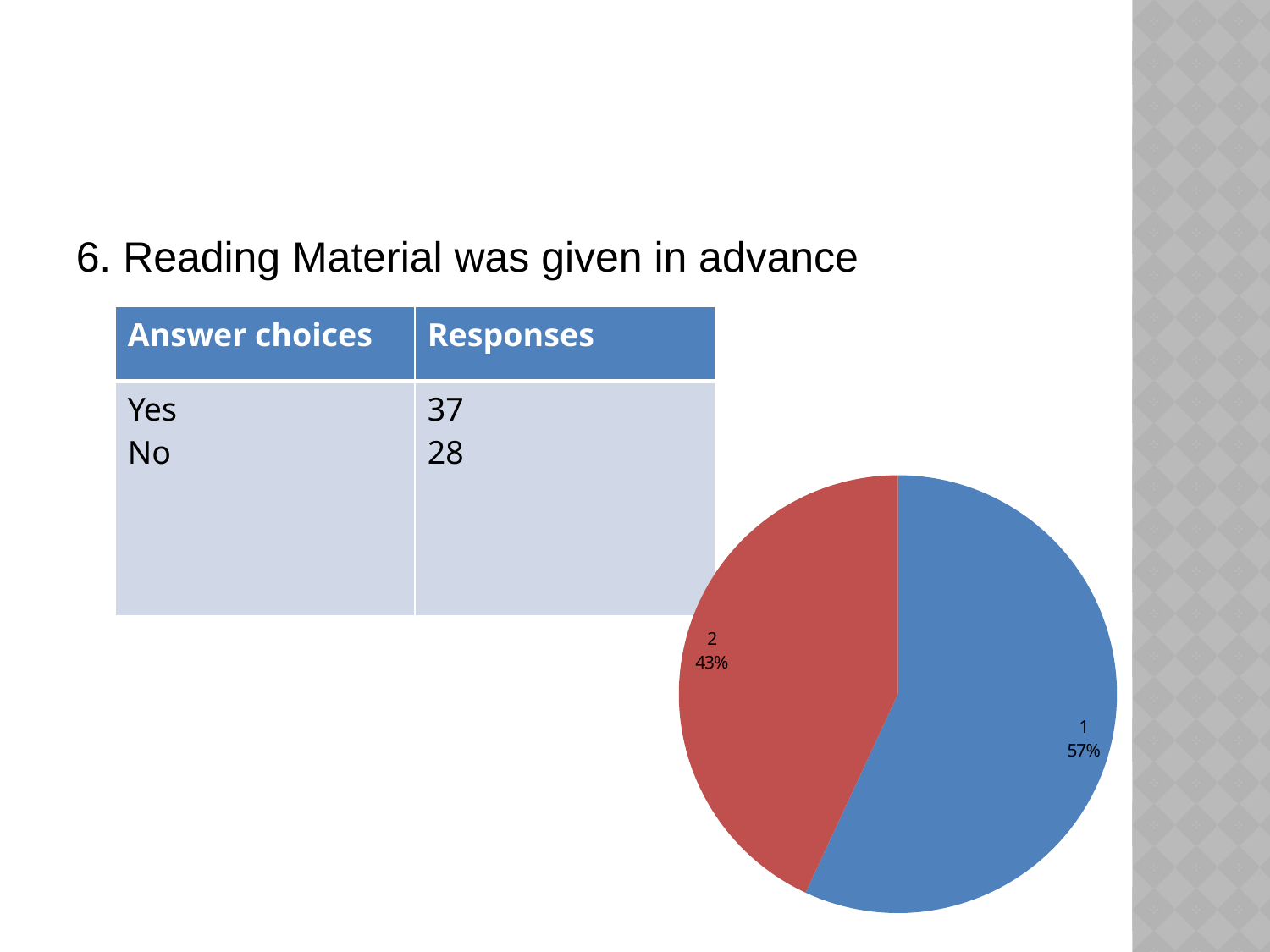
Which slice of the pie chart is the smallest? 2 Is the share for slice 2 in the pie chart greater or less than 50%? less What is the difference in percentage points between slice 1 and slice 2 in the pie chart? 14 percentage points How many slices does the pie chart have? 2 Which slice of the pie chart is the largest? 1 What share of the pie does slice 2 represent? 43% What colour is slice 2 in the pie chart? Red What share of the pie does slice 1 represent? 57% What kind of chart is shown on the slide? Pie chart What colour is slice 1 in the pie chart? Blue Which slice is larger in the pie chart, slice 1 or slice 2? 1 Is the share for slice 1 in the pie chart greater or less than 50%? greater